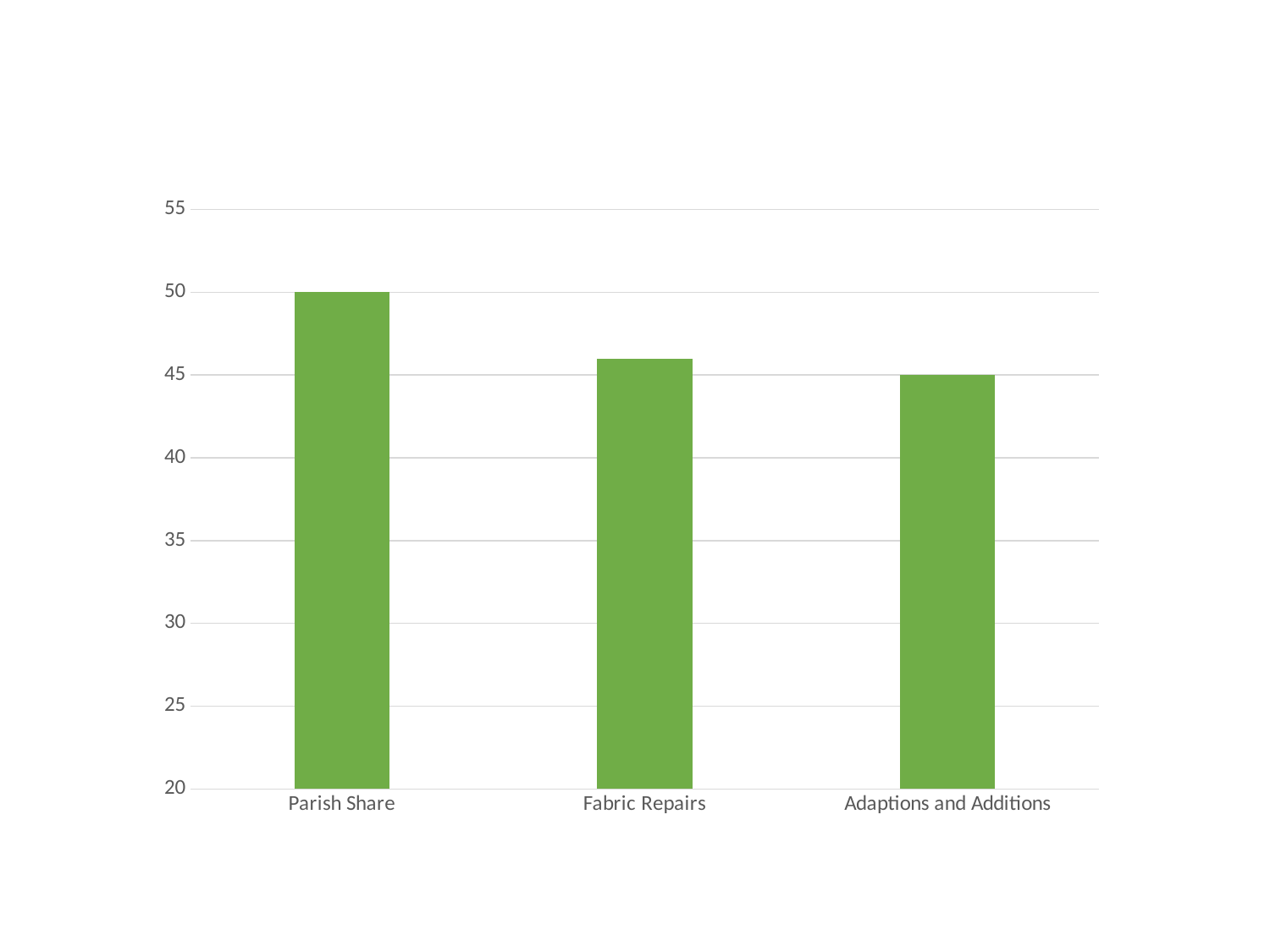
How many categories are shown on the x axis of the chart? 3 What is the value for Adaptions and Additions? 45 What colour are the bars in the chart? green Is the value for Fabric Repairs greater or less than 50? less What is the value for Parish Share? 50 Which is larger, the value for Parish Share or the value for Fabric Repairs? Parish Share Which category has the lowest value? Adaptions and Additions Which category has the highest value? Parish Share What is the difference between the value for Parish Share and the value for Adaptions and Additions? 5 Do the values rise or fall from left to right across the categories? fall Is the value for Fabric Repairs greater or less than 45? greater What type of chart is shown on the slide? bar chart